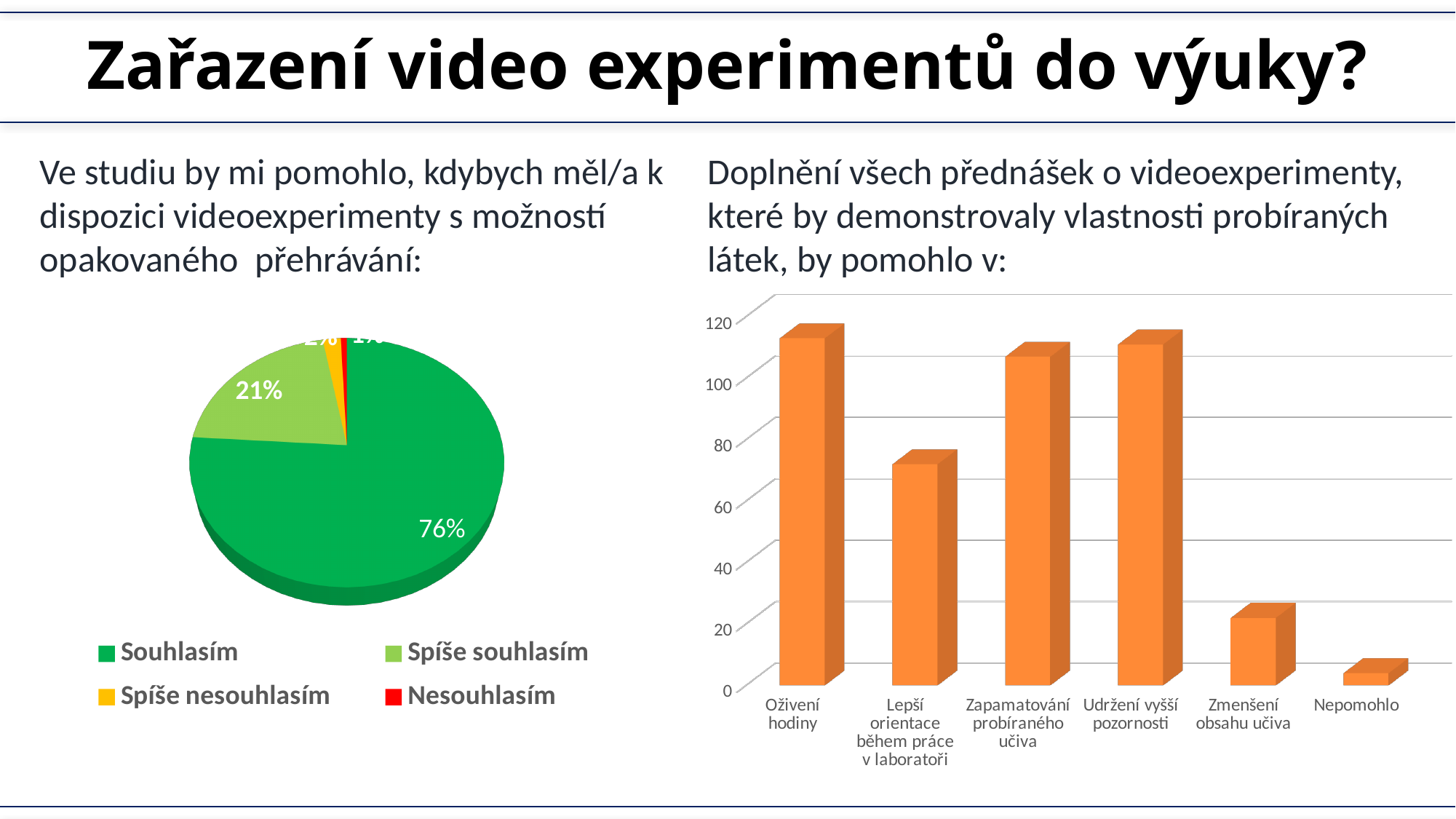
In the right bar chart, is the value for Oživení hodiny greater or less than 100? greater In the right bar chart, which is larger: Oživení hodiny or Lepší orientace během práce v laboratoři? Oživení hodiny How many categories does the legend of the left pie chart list? 4 In the left pie chart, which category has the largest slice? Souhlasím In the right bar chart, which category has the lowest value? Nepomohlo In the right bar chart, is the value for Lepší orientace během práce v laboratoři greater or less than 80? less What kind of chart is the left chart (Ve studiu by mi pomohlo...)? pie chart In the left pie chart, what share is labelled for Souhlasím? 76% In the right bar chart, is the value for Zmenšení obsahu učiva greater or less than 40? less In the left pie chart, what share is labelled for Spíše souhlasím? 21% What kind of chart is the right chart (Doplnění všech přednášek o videoexperimenty...)? bar chart How many categories are shown on the x axis of the right bar chart? 6